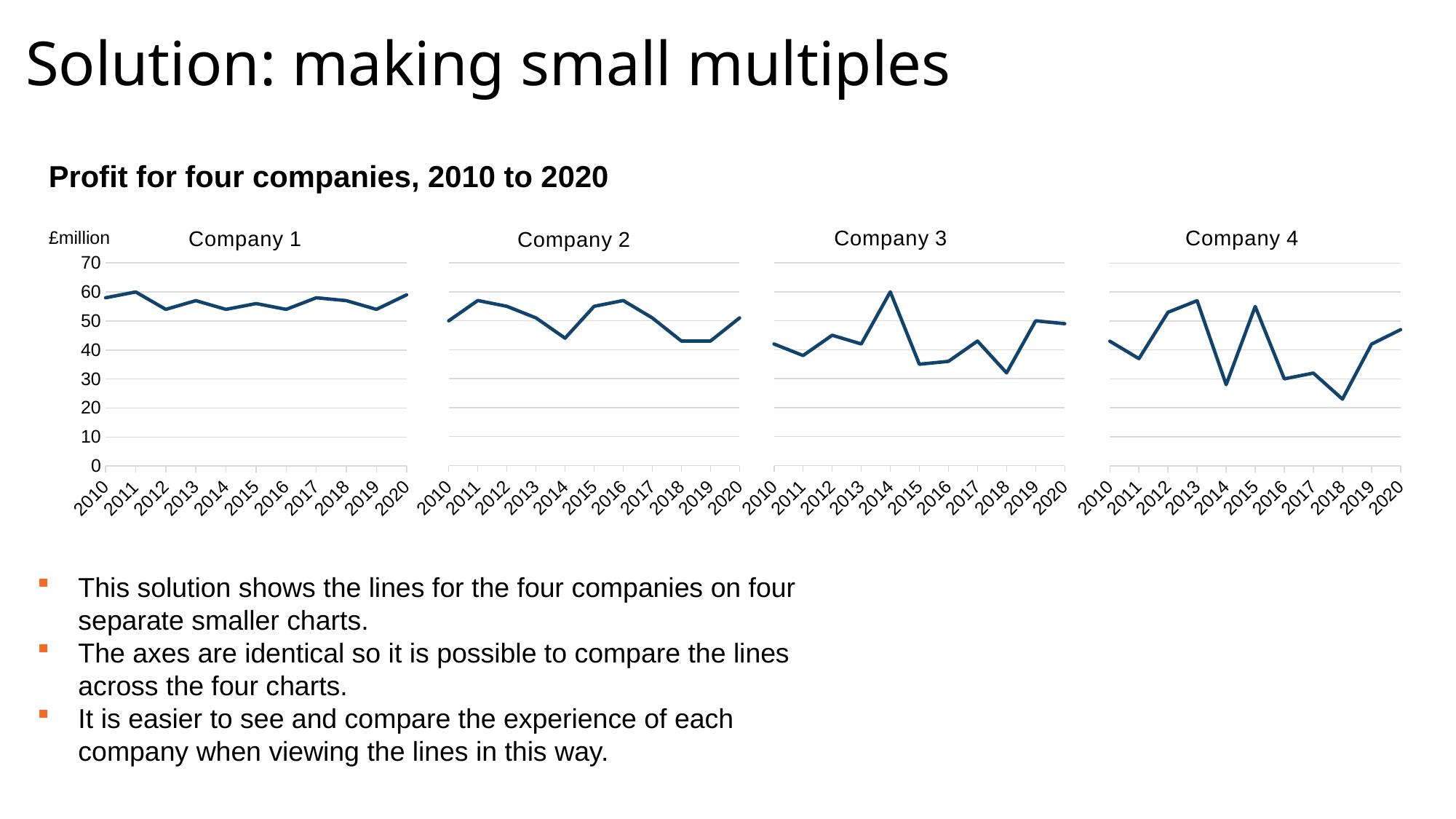
In the Company 4 chart, do the values rise or fall from 2015 to 2018? fall In the Company 3 chart, which is larger, the value for 2014 or the value for 2015? 2014 What unit is shown on the vertical axis of the charts? £million How many years are plotted on the Company 2 chart? 11 How many small charts are shown on the slide? 4 In the Company 4 chart, which year has the lowest profit? 2018 In the Company 2 chart, is the value for 2014 greater or less than 50? less What kind of chart is used for Company 1? line chart In the Company 1 chart, is the value for 2010 greater or less than 50? greater What is the overall title above the four charts? Profit for four companies, 2010 to 2020 In the Company 4 chart, is the value for 2018 greater or less than 30? less In the Company 3 chart, which year has the highest profit? 2014